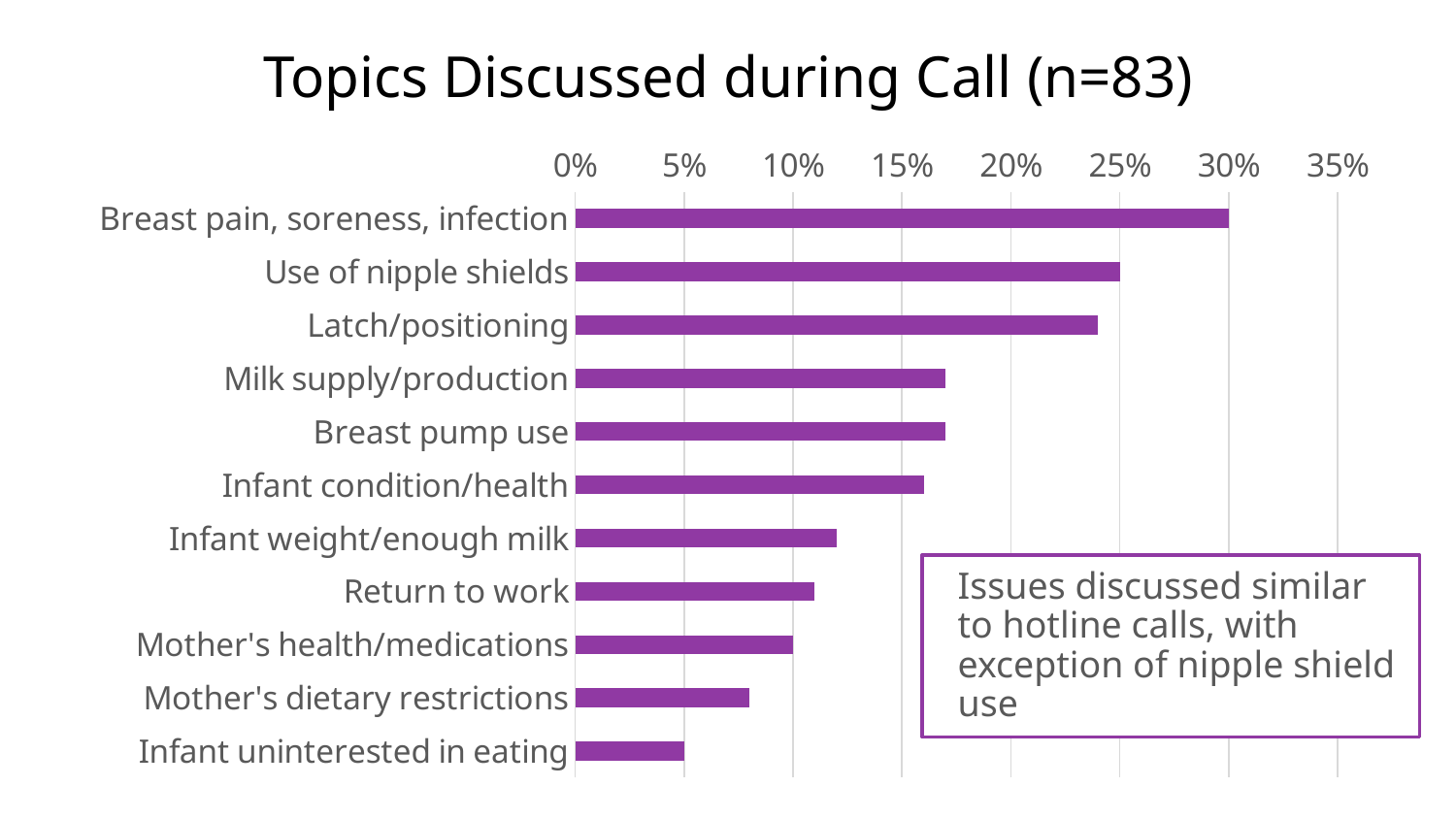
Which topic has the highest percentage? Breast pain, soreness, infection Which is larger, the value for Latch/positioning or the value for Milk supply/production? Latch/positioning What is the title of the chart? Topics Discussed during Call (n=83) What percentage is shown for Breast pain, soreness, infection? 30% Is the value for Infant condition/health greater or less than 15%? greater What type of chart is shown on the slide? Bar chart How many topics are listed in the chart? 11 Which is larger, the value for Infant weight/enough milk or the value for Mother's dietary restrictions? Infant weight/enough milk What percentage is shown for Infant uninterested in eating? 5% Is the value for Latch/positioning greater or less than 20%? greater Which topic has the lowest percentage? Infant uninterested in eating Is the value for Mother's dietary restrictions greater or less than 10%? less